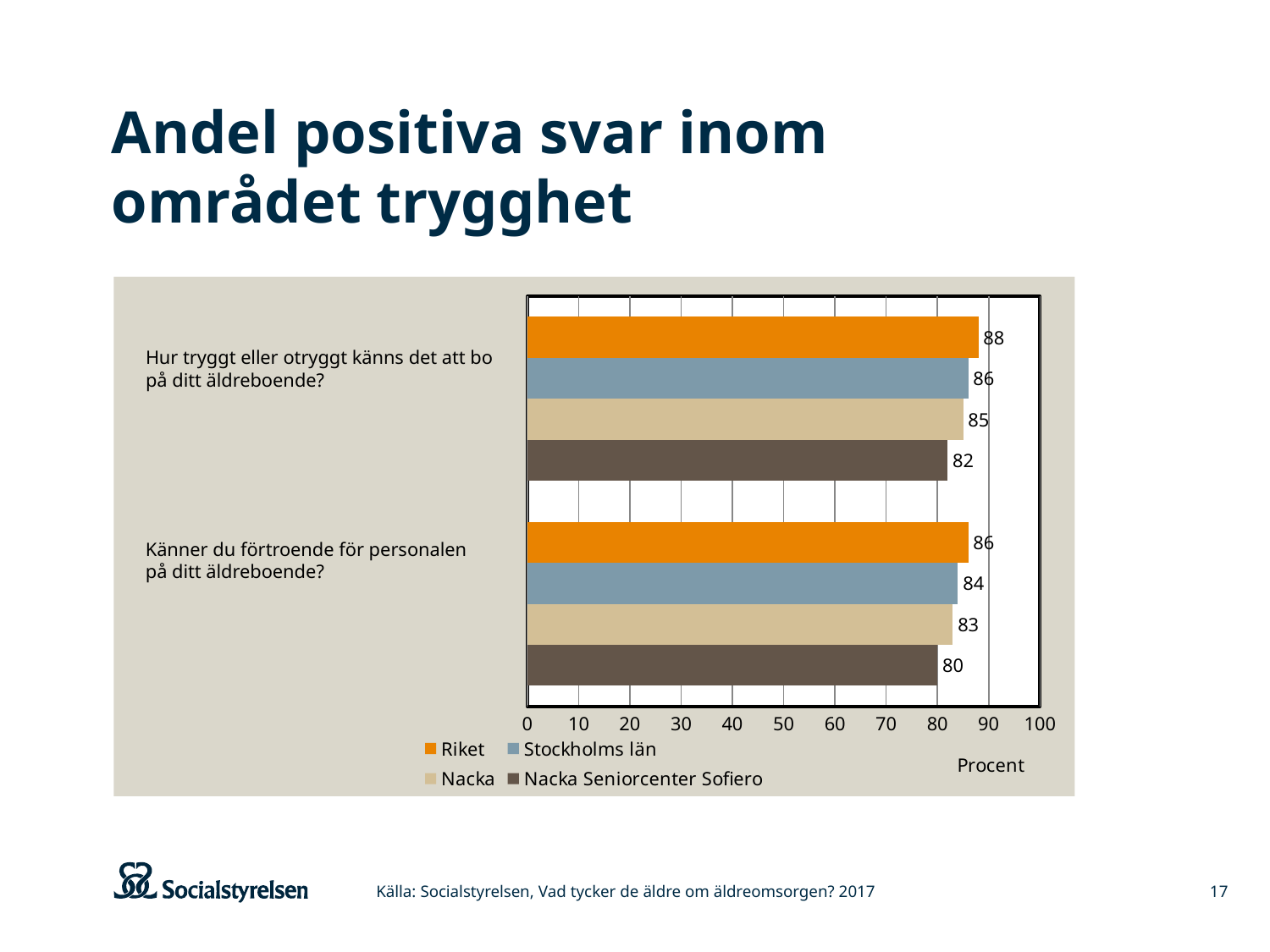
What kind of chart is shown on the slide? Bar chart What is the difference between Riket and Nacka Seniorcenter Sofiero on "Hur tryggt eller otryggt känns det att bo på ditt äldreboende?"? 6 What is the difference between Nacka and Nacka Seniorcenter Sofiero on "Känner du förtroende för personalen på ditt äldreboende?"? 3 How many questions (categories) are shown in the chart? 2 What unit is shown on the horizontal axis label? Procent What is the value for Nacka Seniorcenter Sofiero on the question "Känner du förtroende för personalen på ditt äldreboende?"? 80 Which is larger: the Nacka value for "Hur tryggt eller otryggt känns det att bo på ditt äldreboende?" or the Nacka value for "Känner du förtroende för personalen på ditt äldreboende?"? Hur tryggt eller otryggt känns det att bo på ditt äldreboende? Which series has the highest value for "Hur tryggt eller otryggt känns det att bo på ditt äldreboende?"? Riket What is the value for Stockholms län on the question "Känner du förtroende för personalen på ditt äldreboende?"? 84 What is the value for Riket on the question "Hur tryggt eller otryggt känns det att bo på ditt äldreboende?"? 88 How many series does the legend list? 4 Which series has the lowest value for "Känner du förtroende för personalen på ditt äldreboende?"? Nacka Seniorcenter Sofiero